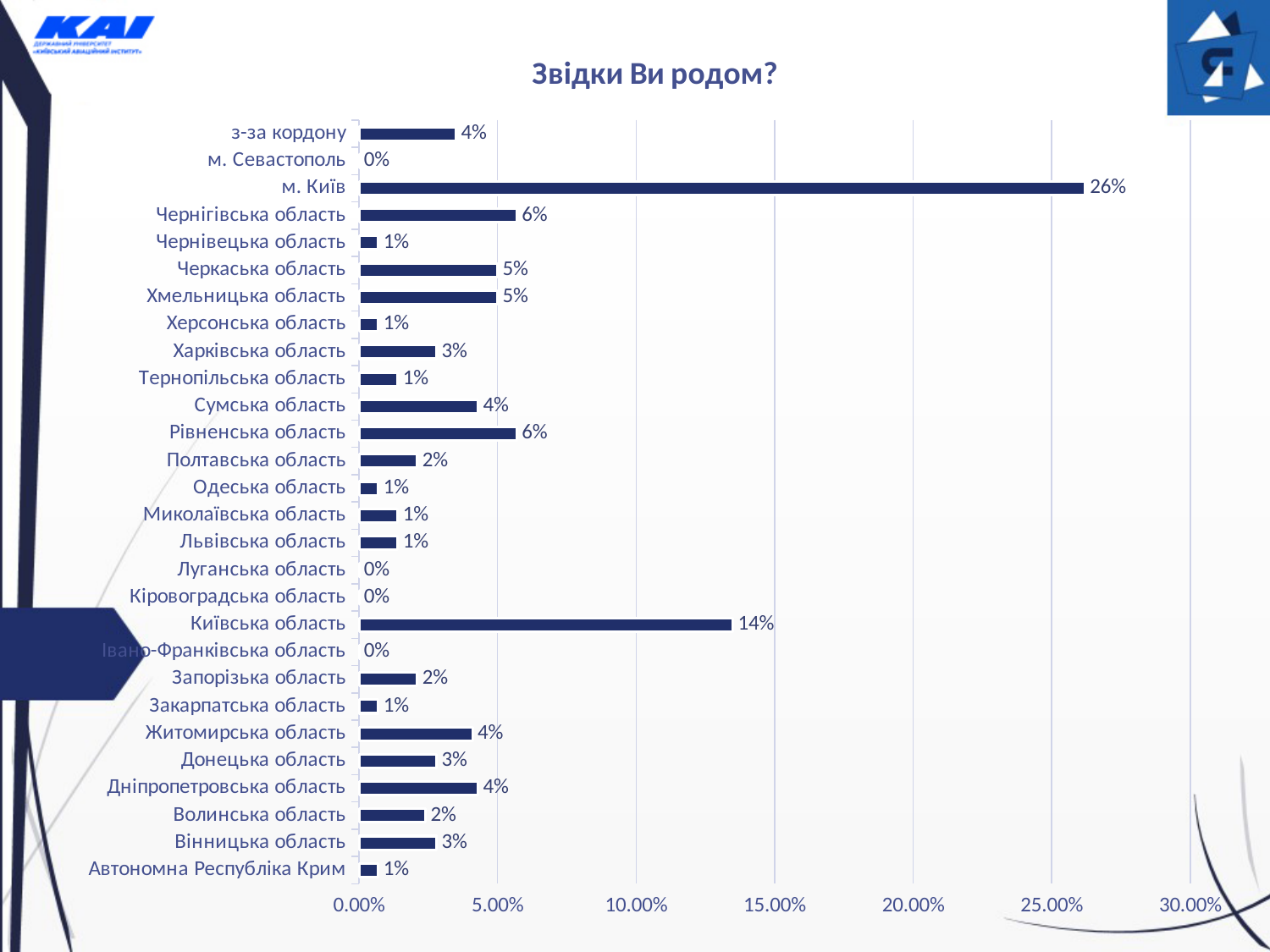
Which category has the highest value? м. Київ What is the title of the chart? Звідки Ви родом? What is the value for з-за кордону? 4% Which is larger, the value for Чернігівська область or Харківська область? Чернігівська область What is the value for Київська область? 14% What type of chart is shown on the slide? Bar chart How many categories are shown on the chart? 28 What is the value for Чернігівська область? 6% What is the value for м. Севастополь? 0% What is the value for м. Київ? 26% Is the value for м. Київ greater or less than 25.00%? greater What is the difference between the values for м. Київ and Київська область? 12%